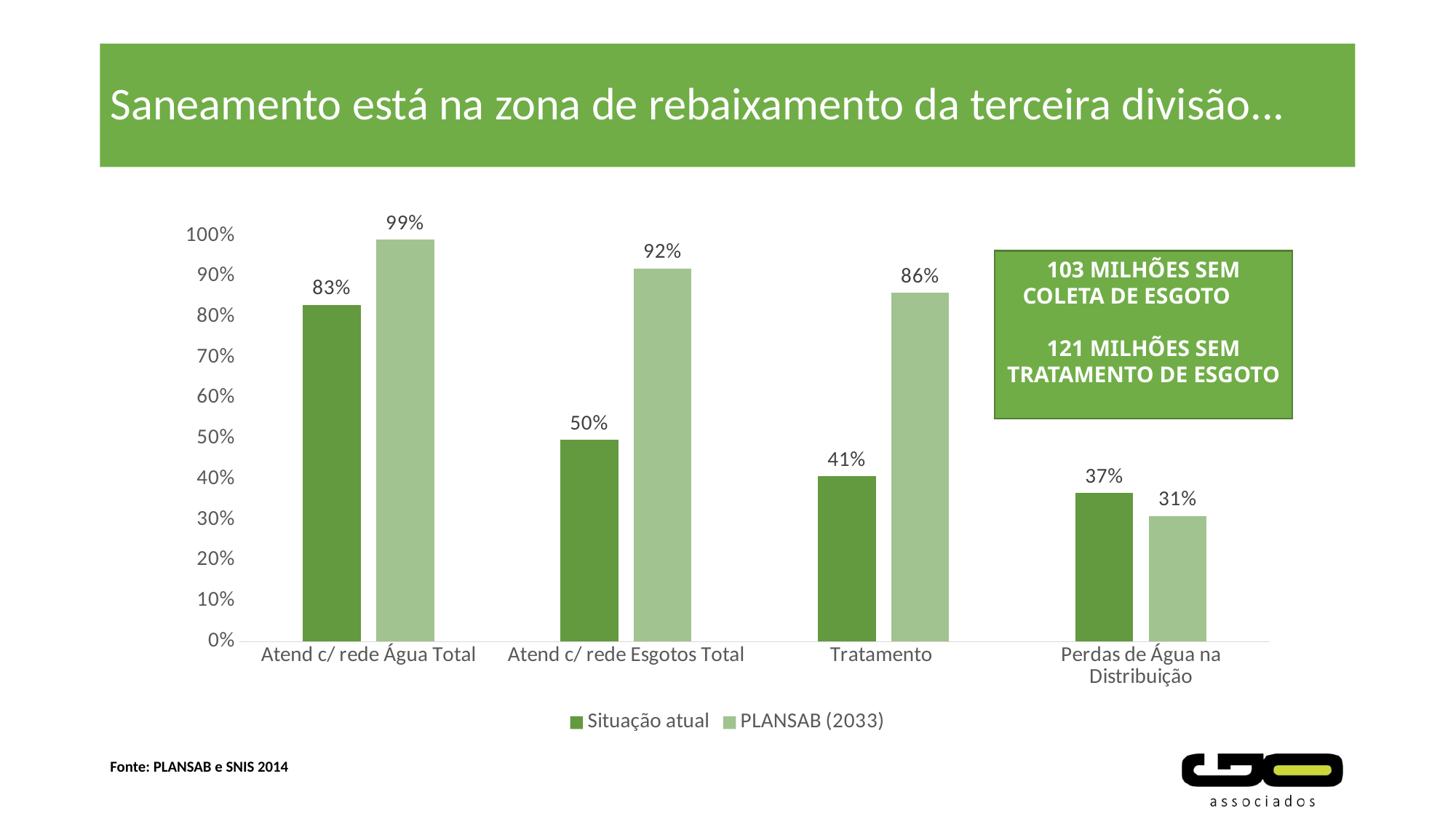
What is the Situação atual value for Atend c/ rede Água Total? 83% Which category has the highest PLANSAB (2033) value? Atend c/ rede Água Total How many categories are shown on the x axis? 4 What is the Situação atual value for Tratamento? 41% What is the difference between the PLANSAB (2033) and Situação atual values for Tratamento? 45% What is the title of the slide? Saneamento está na zona de rebaixamento da terceira divisão... What is the PLANSAB (2033) value for Perdas de Água na Distribuição? 31% Which category has the lowest Situação atual value? Perdas de Água na Distribuição Which is larger for Perdas de Água na Distribuição: Situação atual or PLANSAB (2033)? Situação atual How many series does the legend list? 2 What kind of chart is shown on the slide? Bar chart What is the PLANSAB (2033) value for Atend c/ rede Esgotos Total? 92%